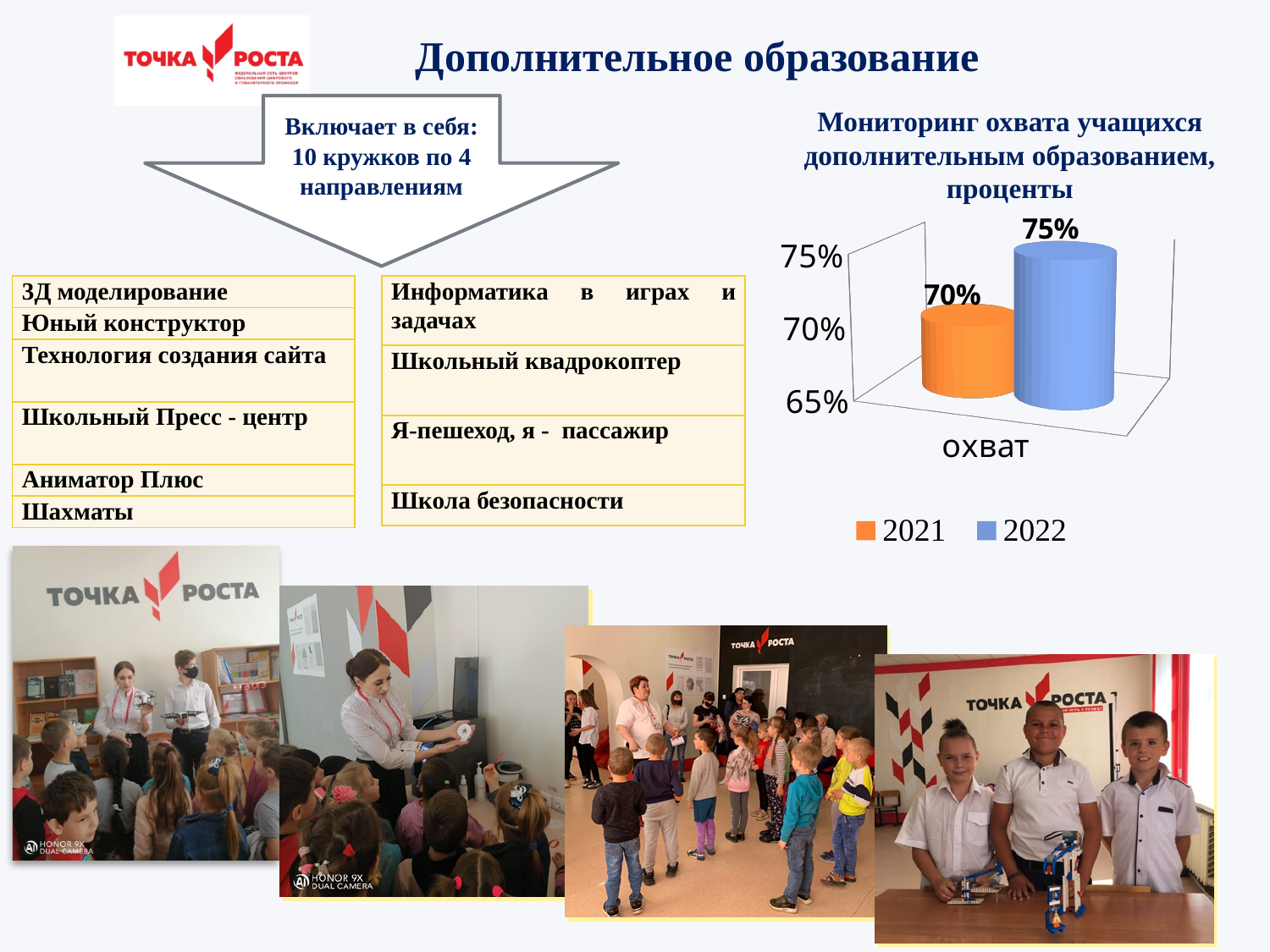
How many series does the chart legend list? 2 What is the difference between the 2022 and 2021 values in the chart? 5% Which colour represents the 2022 series in the chart? blue What kind of chart is shown on the slide? bar chart What is the category label on the x axis of the chart? охват How many categories are shown on the x axis of the chart? 1 Which series has the lowest value in the chart? 2021 Which year has the higher value in the chart, 2021 or 2022? 2022 What is the value for 2022 in the chart? 75% Is the value for 2021 greater or less than 65%? greater Which series has the highest value in the chart? 2022 What is the value for 2021 in the chart? 70%